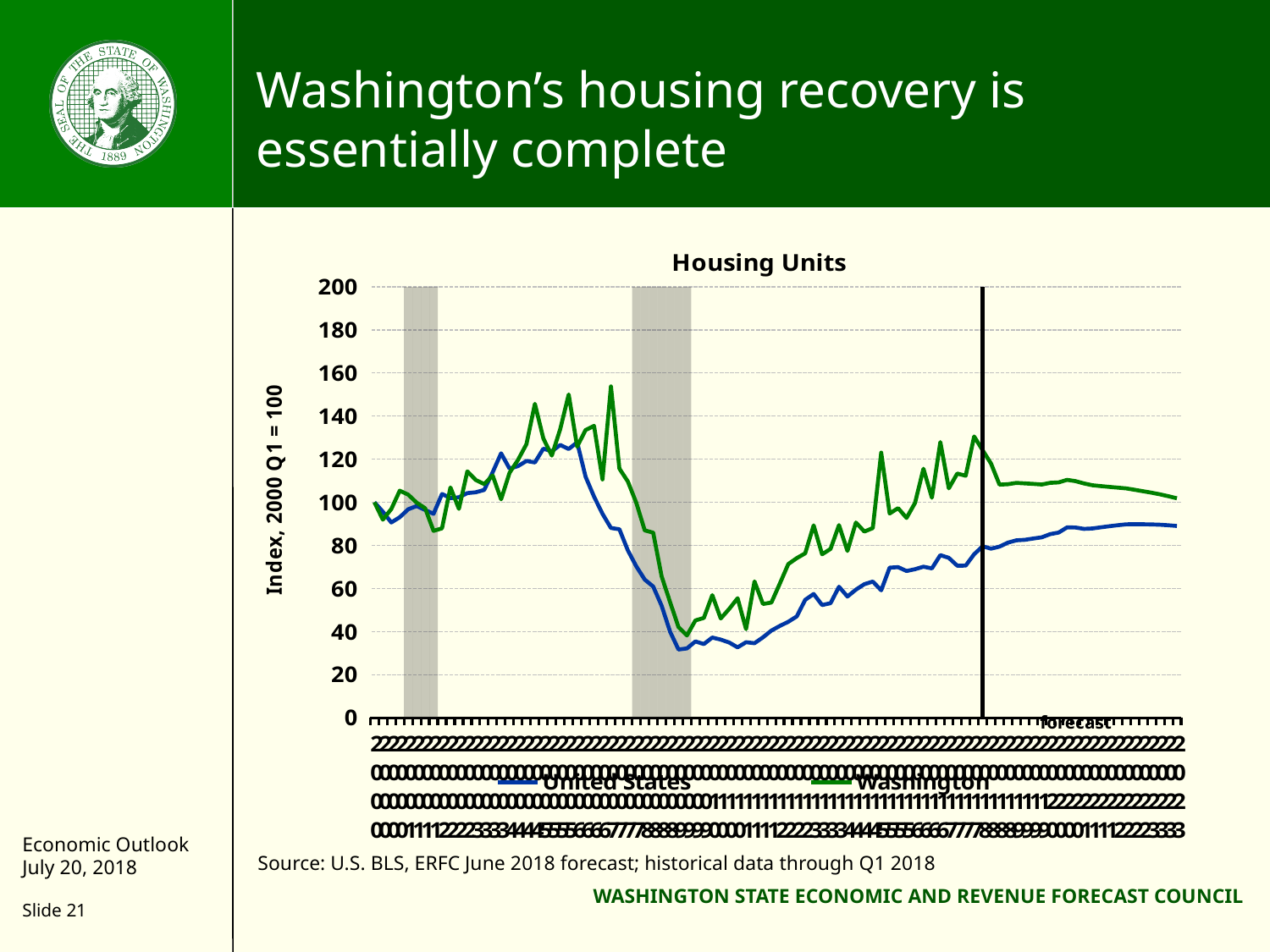
What are the two series named in the legend of the Housing Units chart? United States and Washington In the forecast period to the right of the vertical black line, does the Washington series rise or fall? fall What is the highest value shown on the y-axis of the Housing Units chart? 200 Is the lowest value of the United States series greater or less than 40? less Is the peak value of the Washington series greater or less than 140? greater Is the value of the Washington series at the right end of the chart greater or less than 120? less What is the y-axis label of the Housing Units chart? Index, 2000 Q1 = 100 What kind of chart is shown on the slide? line chart How many series does the legend of the Housing Units chart list? 2 Which series reaches the higher peak value in the Housing Units chart? Washington At the right end of the Housing Units chart, which series is higher, United States or Washington? Washington